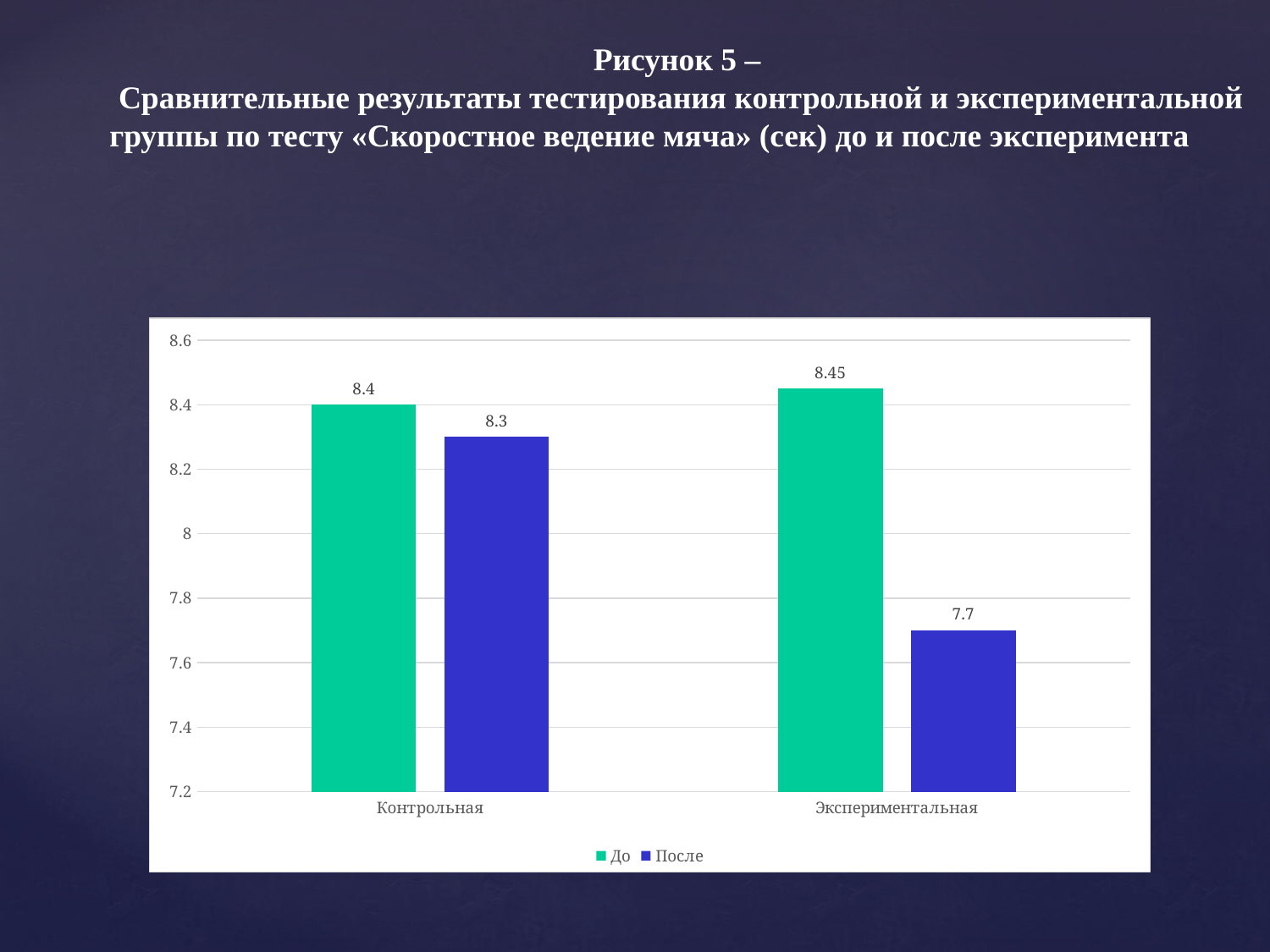
How many series does the legend list? 2 What is the value for the Контрольная group in the До series? 8.4 Which is larger: the После value for Контрольная or the После value for Экспериментальная? Контрольная What is the value for the Экспериментальная group in the После series? 7.7 What kind of chart is shown on the slide? Bar chart What is the difference between the До and После values for the Экспериментальная group? 0.75 How many groups (categories) are shown on the x axis? 2 Which group has the highest value in the До series? Экспериментальная Which group has the lowest value in the После series? Экспериментальная What is the value for the Экспериментальная group in the До series? 8.45 What is the value for the Контрольная group in the После series? 8.3 What is the difference between the До and После values for the Контрольная group? 0.1